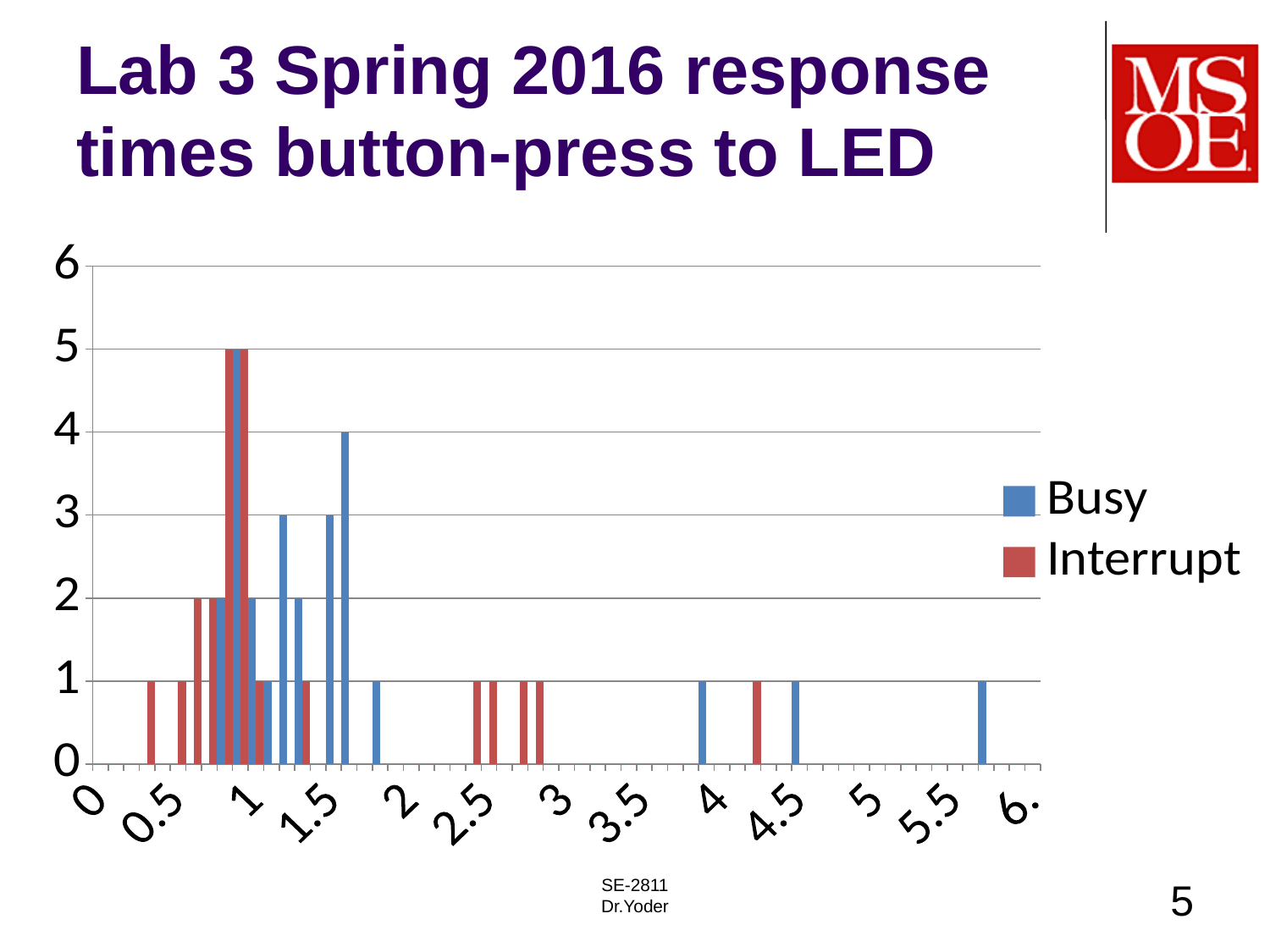
Is the tallest Busy bar greater or less than 3? greater What is the tallest bar height reached by any series on the chart? 5 What is the highest value shown on the y axis? 6 How many series does the legend list? 2 Which series has the bar located just below 6 on the x axis? Busy What is the tallest bar height reached by the Interrupt series? 5 Which colour represents the Interrupt series? red What kind of chart is shown on the slide? bar chart What is the tallest bar height reached by the Busy series? 5 What are the two series named in the legend? Busy and Interrupt Which series has the bar located just above 4 on the x axis? Interrupt What is the height of the bar located just below 6 on the x axis? 1